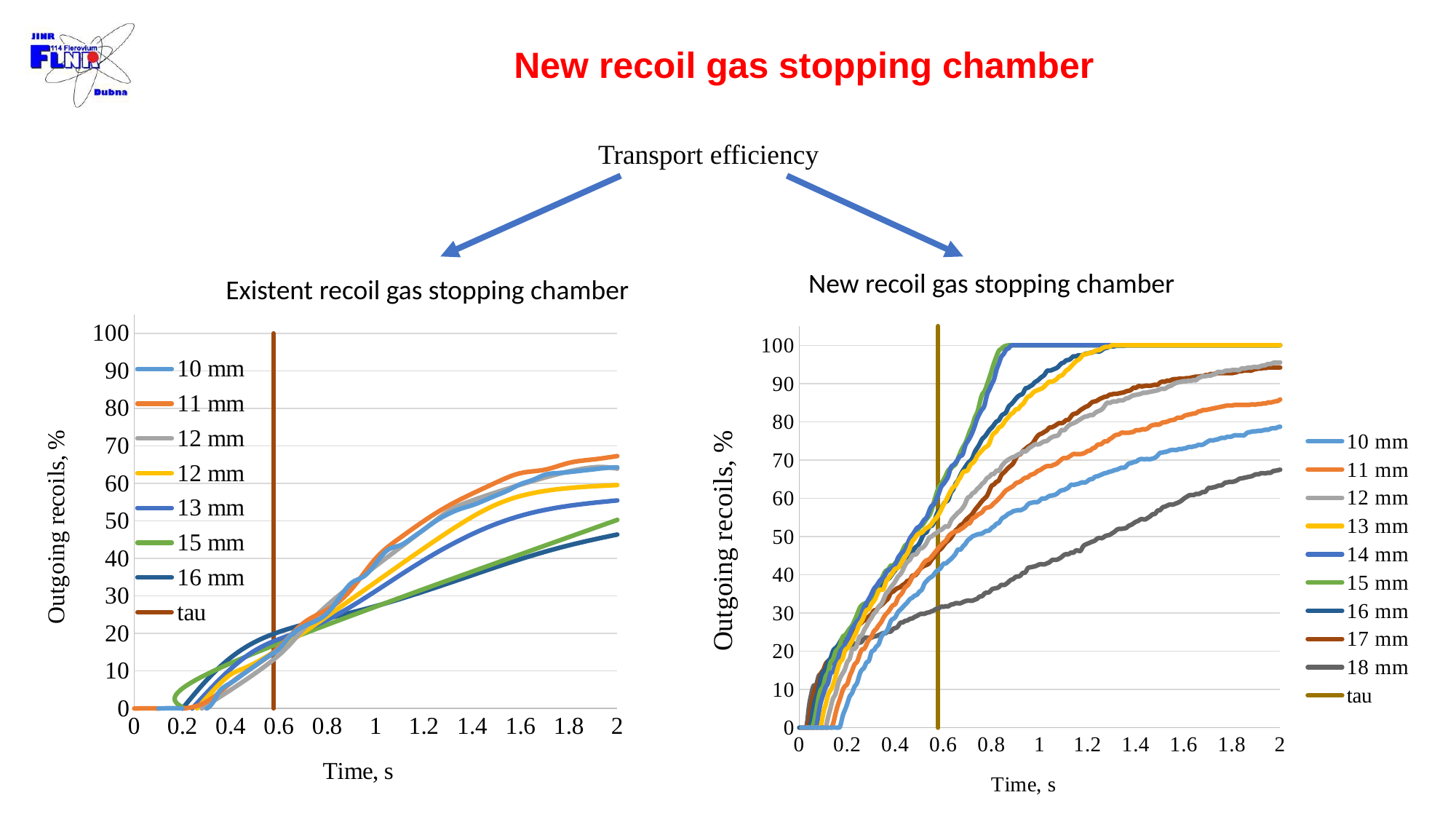
In the 'Existent recoil gas stopping chamber' chart, is the value for 16 mm at 2 s greater or less than 50? less In the 'Existent recoil gas stopping chamber' chart, which series has the highest value at 2 s? 11 mm How many series does the legend of the 'Existent recoil gas stopping chamber' chart list? 8 How many series does the legend of the 'New recoil gas stopping chamber' chart list? 10 In the 'New recoil gas stopping chamber' chart, which series has the lowest value at 2 s? 18 mm In the 'New recoil gas stopping chamber' chart, is the value for 11 mm at 2 s greater or less than 80? greater In the 'Existent recoil gas stopping chamber' chart, which series has the lowest value at 2 s? 16 mm What is the y-axis label of the 'New recoil gas stopping chamber' chart? Outgoing recoils, % In the 'Existent recoil gas stopping chamber' chart, is the value for 11 mm at 2 s greater or less than 60? greater In the 'New recoil gas stopping chamber' chart, which is larger at 2 s: the value for 10 mm or the value for 18 mm? 10 mm What kind of chart is the 'Existent recoil gas stopping chamber' chart? line chart